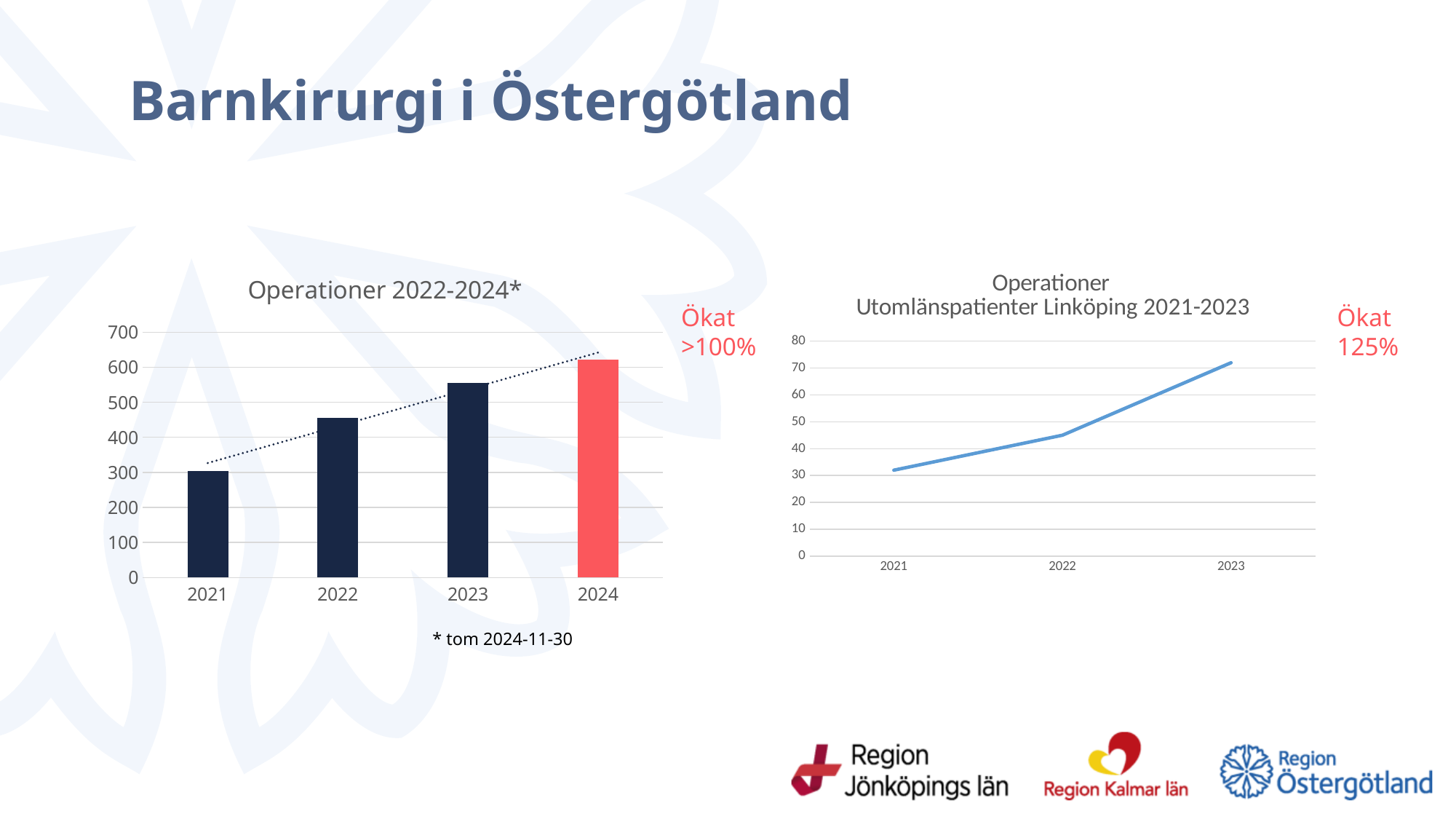
What kind of chart is the right chart titled "Operationer Utomlänspatienter Linköping 2021-2023"? line chart In the right chart "Operationer Utomlänspatienter Linköping 2021-2023", do the values rise or fall from 2021 to 2023? rise In the left chart "Operationer 2022-2024*", which year has the highest bar? 2024 In the left chart "Operationer 2022-2024*", which year's bar is coloured red instead of dark blue? 2024 In the left chart "Operationer 2022-2024*", how many years are shown on the x axis? 4 In the left chart "Operationer 2022-2024*", do the values rise or fall from 2021 to 2024? rise In the right chart "Operationer Utomlänspatienter Linköping 2021-2023", how many data points are plotted? 3 What kind of chart is the left chart titled "Operationer 2022-2024*"? bar chart In the left chart "Operationer 2022-2024*", which year has the lowest bar? 2021 In the left chart "Operationer 2022-2024*", is the value for 2021 greater or less than 400? less In the left chart "Operationer 2022-2024*", which is larger, the value for 2022 or the value for 2023? 2023 In the right chart "Operationer Utomlänspatienter Linköping 2021-2023", is the value for 2023 greater or less than 60? greater